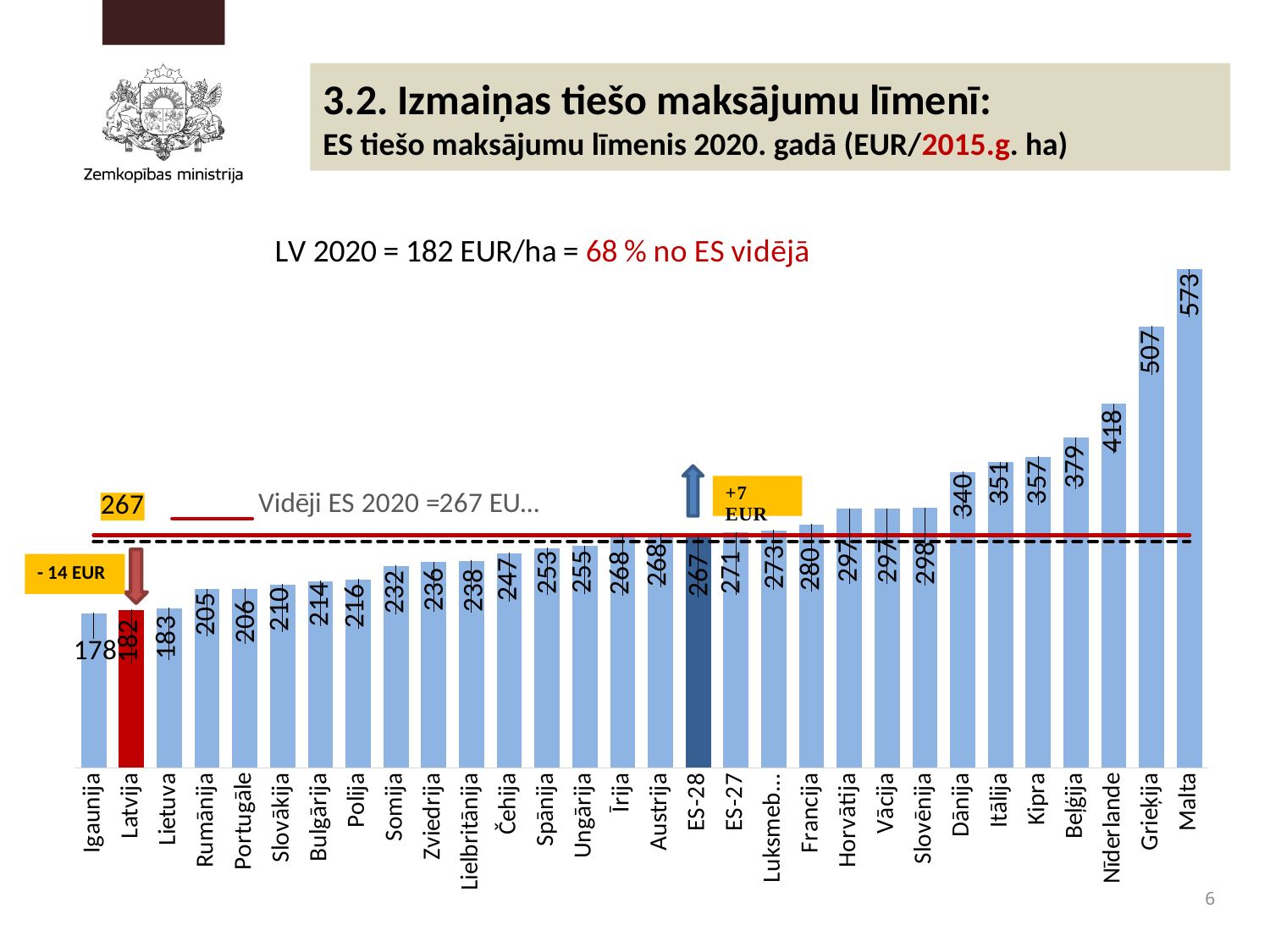
What is the value for Latvija? 182 What is the difference between the values for Malta and Grieķija? 66 Which category's bar is coloured red? Latvija Which category has the highest value? Malta What is the value for ES-28? 267 How many categories are shown on the x axis? 30 What kind of chart is shown on the slide? bar chart What is the value for Malta? 573 What is the difference between the values for ES-28 and Latvija? 85 Which is larger, the value for Francija or the value for Polija? Francija Which category has the lowest value? Igaunija What is the value for Dānija? 340